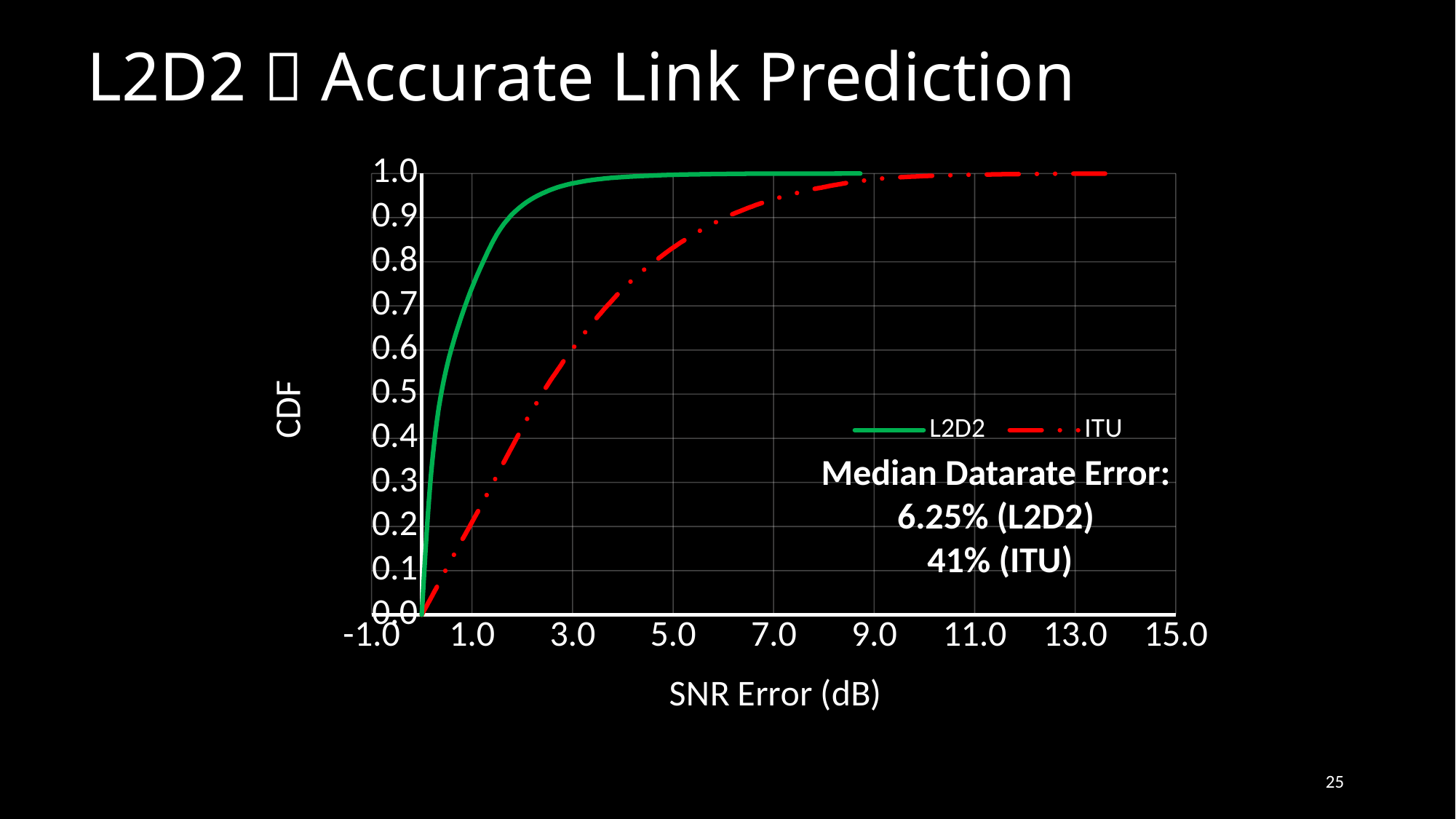
What kind of chart is shown on the slide? line chart At an SNR Error of 1.0 dB, is the CDF value for L2D2 greater or less than 0.5? greater What are the two series named in the legend? L2D2 and ITU At an SNR Error of 5.0 dB, is the CDF value for ITU greater or less than 0.7? greater At an SNR Error of 3.0 dB, which series has the higher CDF value, L2D2 or ITU? L2D2 According to the text on the chart, what is the median datarate error for ITU? 41% At an SNR Error of 3.0 dB, is the CDF value for L2D2 greater or less than 0.9? greater Which series reaches a CDF of 1.0 at a lower SNR Error? L2D2 Do the CDF values rise or fall as SNR Error increases along the x axis? rise How many series does the legend list? 2